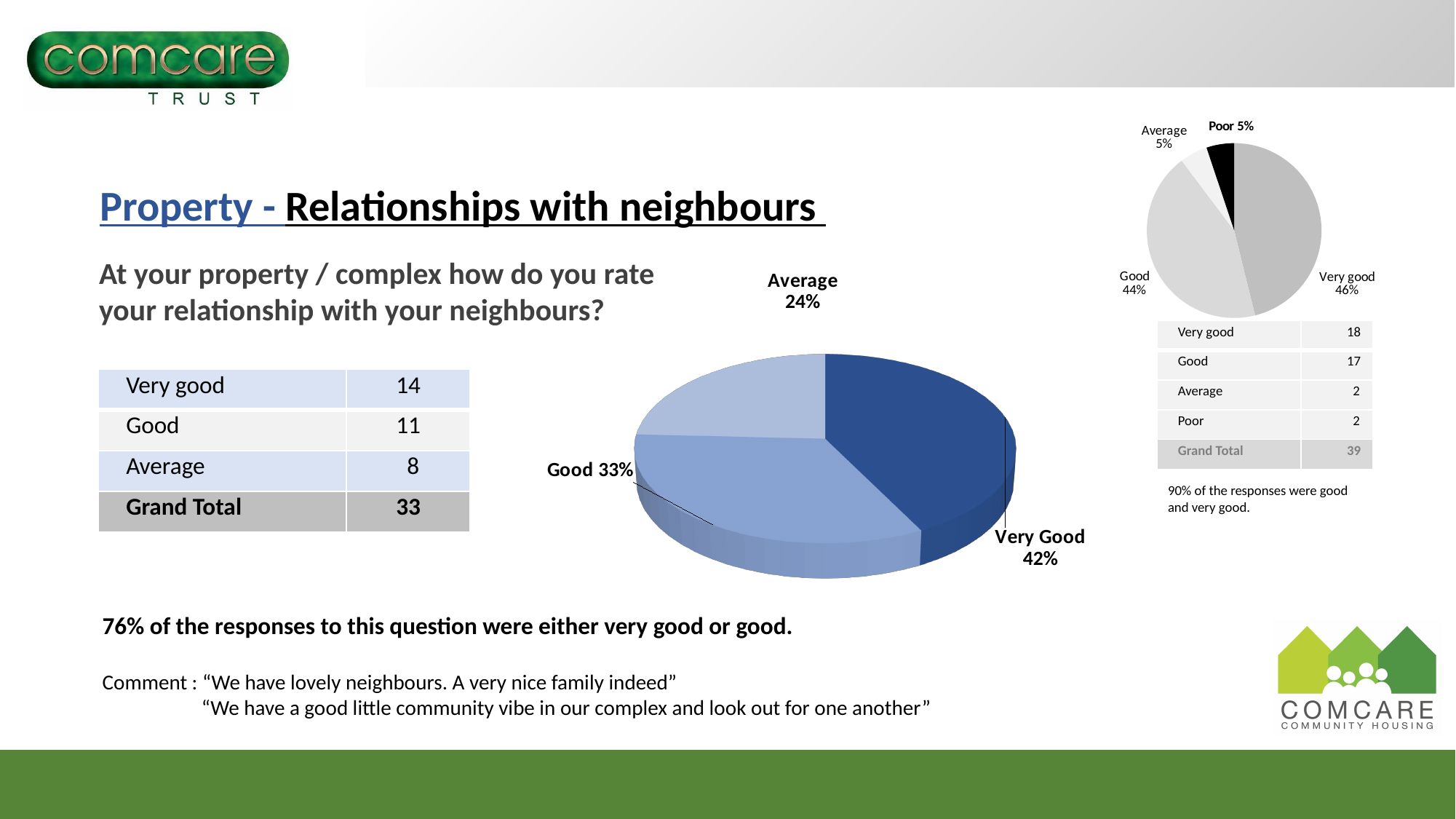
What kind of chart is the large chart in the centre of the slide? Pie chart On the small pie chart at the top right of the slide, how many slices are there? 4 On the small pie chart at the top right of the slide, which is larger, Very good or Good? Very good On the large pie chart in the centre of the slide, how many slices are there? 3 On the large pie chart in the centre of the slide, which category has the smallest slice? Average On the large pie chart in the centre of the slide, what share is labelled for Very Good? 42% On the large pie chart in the centre of the slide, what share is labelled for Average? 24% On the large pie chart in the centre of the slide, which category has the largest slice? Very Good On the small pie chart at the top right of the slide, what share is labelled for Poor? 5% On the large pie chart in the centre of the slide, what is the difference in percentage points between Very Good and Good? 9 On the small pie chart at the top right of the slide, what share is labelled for Very good? 46% On the large pie chart in the centre of the slide, what share is labelled for Good? 33%